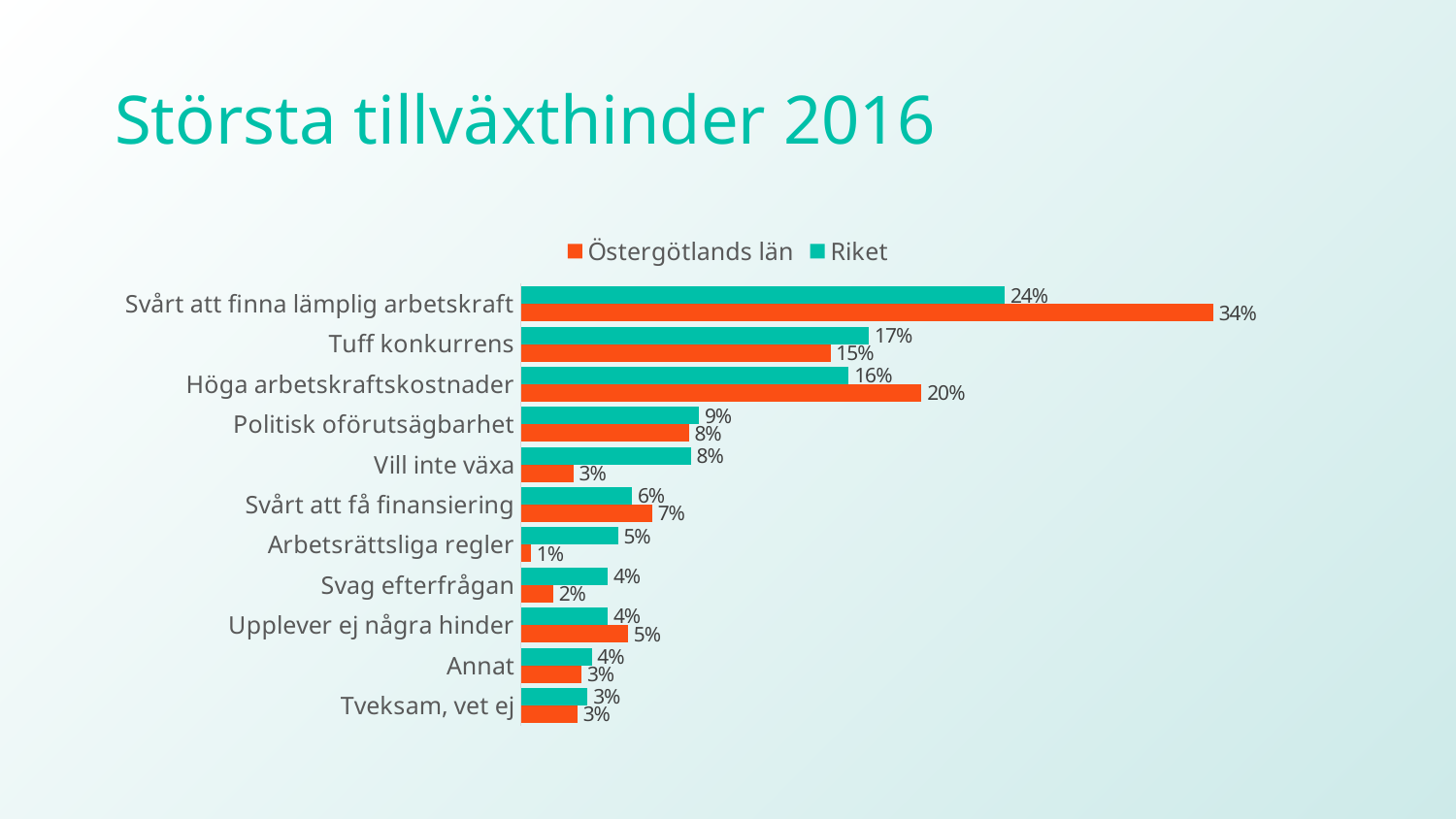
What type of chart is shown on the slide? Bar chart What is the difference between Östergötlands län and Riket for 'Svårt att finna lämplig arbetskraft'? 10% What is the value for Östergötlands län for 'Vill inte växa'? 3% How many series does the legend list? 2 Which is larger for 'Tuff konkurrens': Östergötlands län or Riket? Riket What is the value for Riket for 'Höga arbetskraftskostnader'? 16% Which is larger for 'Höga arbetskraftskostnader': Östergötlands län or Riket? Östergötlands län Which category has the highest value for Östergötlands län? Svårt att finna lämplig arbetskraft What is the value for Östergötlands län for 'Svårt att finna lämplig arbetskraft'? 34% How many categories are shown in the chart? 11 Which category has the lowest value for Östergötlands län? Arbetsrättsliga regler What is the difference between Riket and Östergötlands län for 'Vill inte växa'? 5%